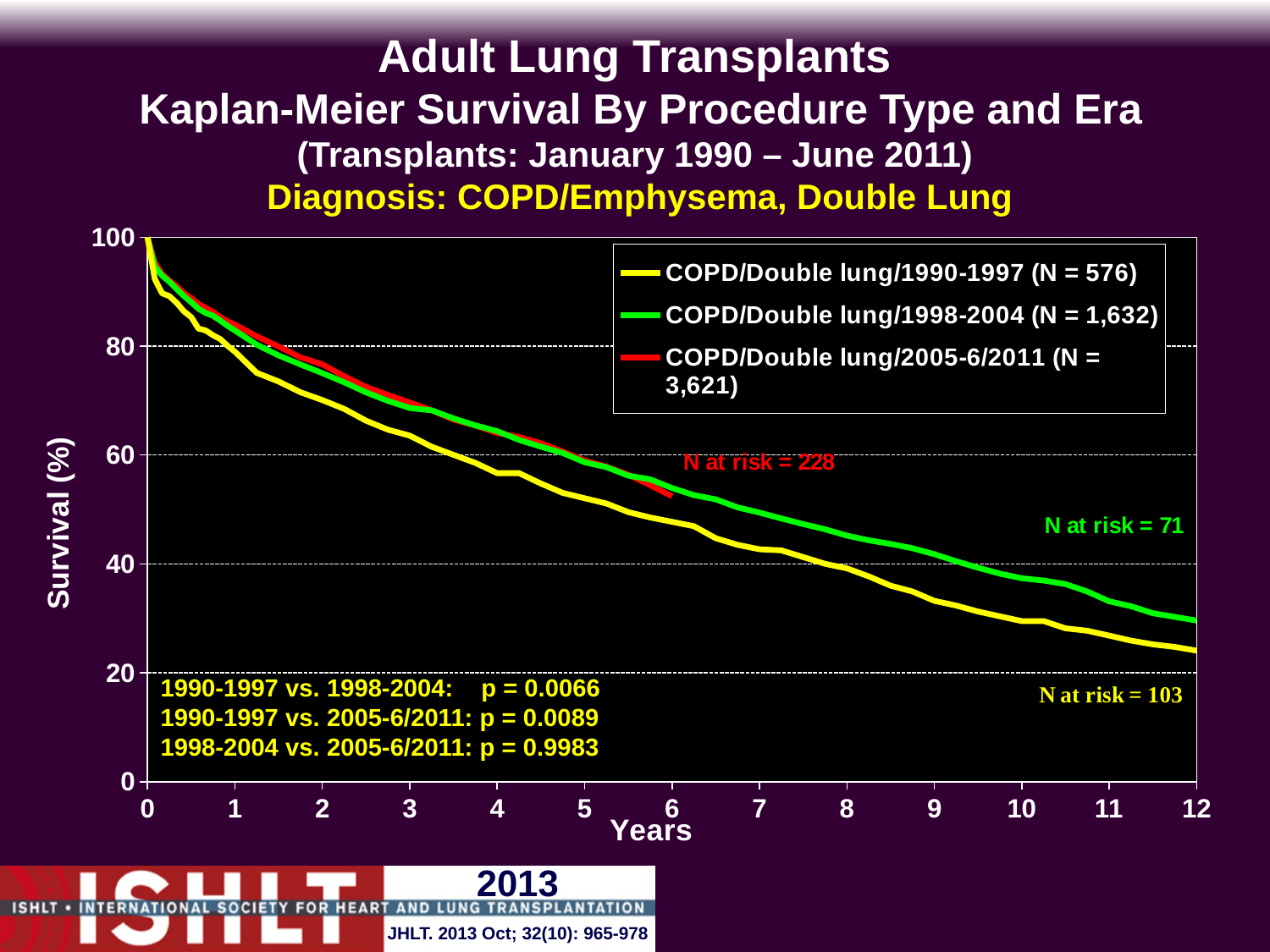
Which series has the lowest survival curve across the chart? COPD/Double lung/1990-1997 Is the survival value for COPD/Double lung/2005-6/2011 at 6 years greater or less than 60? less Is the survival value for COPD/Double lung/1990-1997 at 12 years greater or less than 40? less How many series does the legend list? 3 What kind of chart is shown on the slide? line chart What is the p-value shown for 1998-2004 vs. 2005-6/2011? 0.9983 Do the survival curves rise or fall as years increase? fall What sample size (N) does the legend give for COPD/Double lung/1990-1997? 576 What is the N at risk shown for the COPD/Double lung/2005-6/2011 series? 228 What is the N at risk shown for the COPD/Double lung/1998-2004 series? 71 At 12 years, which series has higher survival: COPD/Double lung/1990-1997 or COPD/Double lung/1998-2004? COPD/Double lung/1998-2004 Is the survival value for COPD/Double lung/1998-2004 at 8 years greater or less than 40? greater